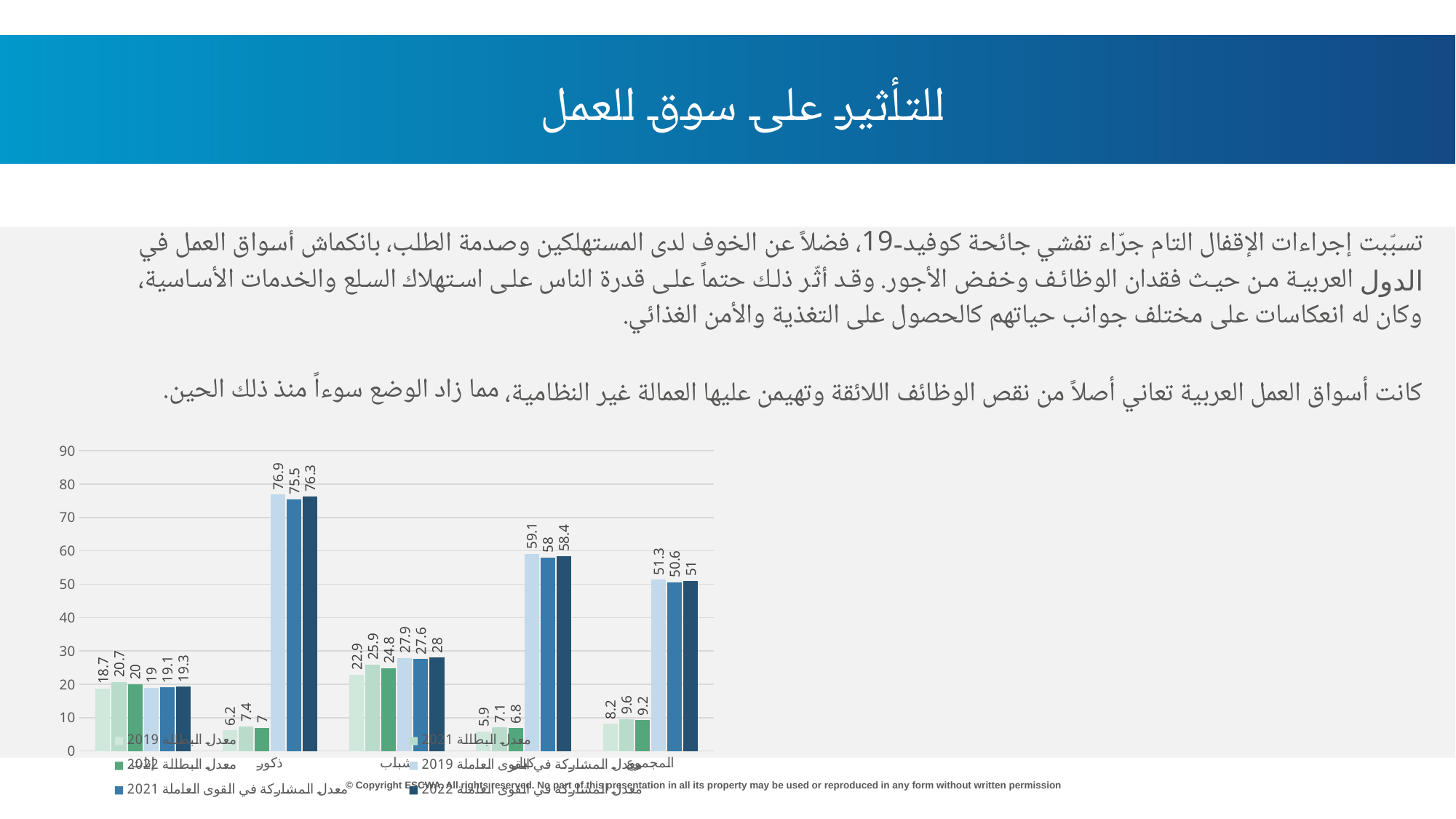
What is the highest value shown on the vertical axis? 90 What is the unemployment rate (معدل البطالة) for youth (شباب) in 2021? 25.9 For youth (شباب), which is larger: the unemployment rate in 2019 or in 2021? 2021 What kind of chart is shown on the slide? bar chart How many series does the legend list? 6 Which bar in the chart has the highest value? معدل المشاركة في القوى العاملة 2019 for ذكور (76.9) What is the unemployment rate for the total (المجموع) in 2019? 8.2 What is the labour force participation rate (معدل المشاركة في القوى العاملة) for males (ذكور) in 2019? 76.9 By how much did the male (ذكور) labour force participation rate fall from 2019 to 2021? 1.4 What is the difference between the youth (شباب) labour force participation rate in 2022 and in 2019? 0.1 How does the total (المجموع) unemployment rate change from 2019 to 2021 to 2022? rises from 8.2 to 9.6, then falls to 9.2 What is the labour force participation rate for the total (المجموع) in 2022? 51